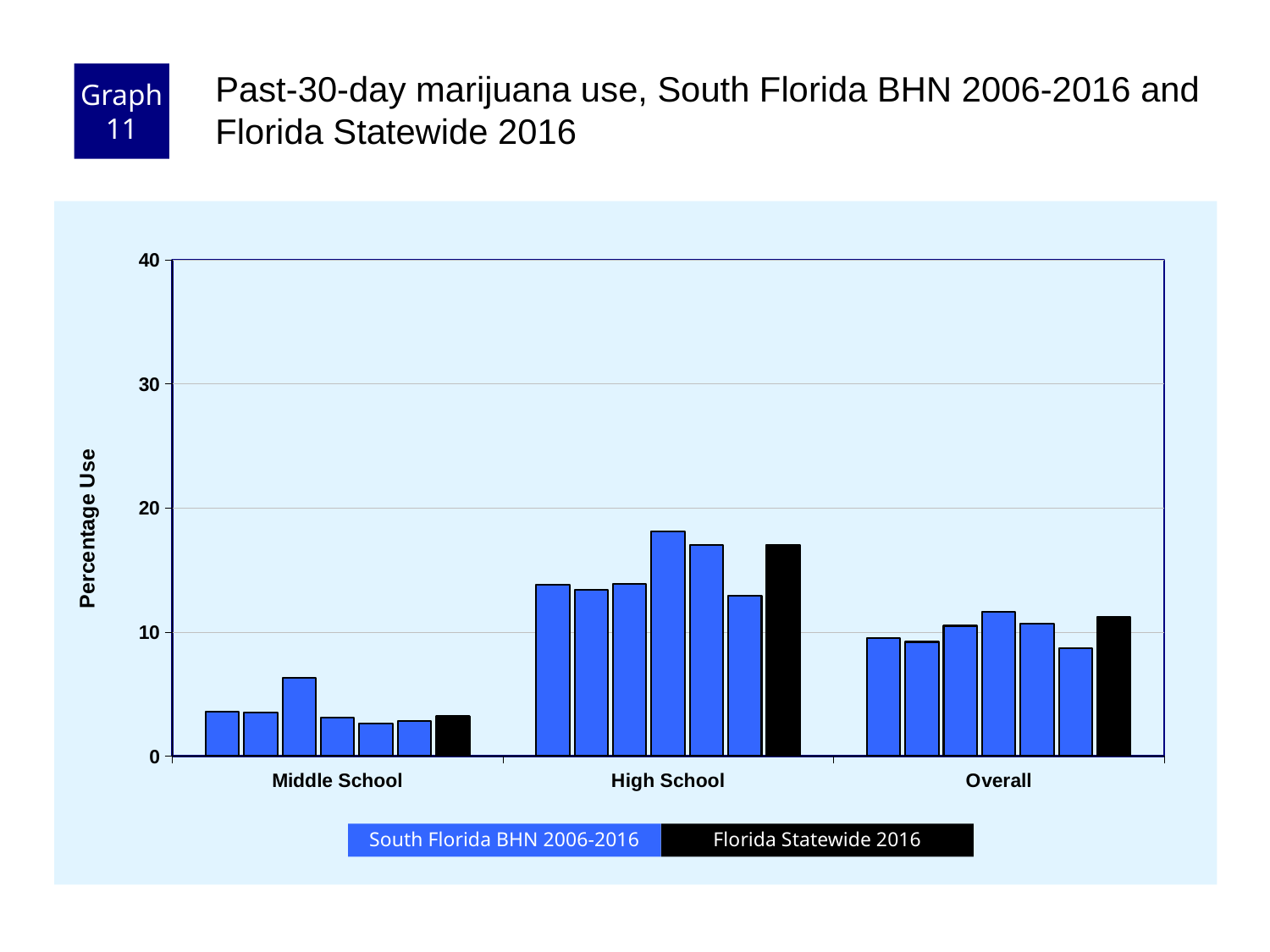
Which series is shown in black in the legend? Florida Statewide 2016 Which is larger: the Florida Statewide 2016 value for High School or for Overall? High School What is the label on the y axis? Percentage Use Is the Florida Statewide 2016 value for Overall greater or less than 20? less Is the Florida Statewide 2016 value for High School greater or less than 10? greater What kind of chart is shown on the slide? bar chart Is the Florida Statewide 2016 value for Middle School greater or less than 10? less Which category has the highest bars overall? High School Which category has the lowest bars overall? Middle School How many series does the legend list? 2 How many school-level categories are shown on the x axis? 3